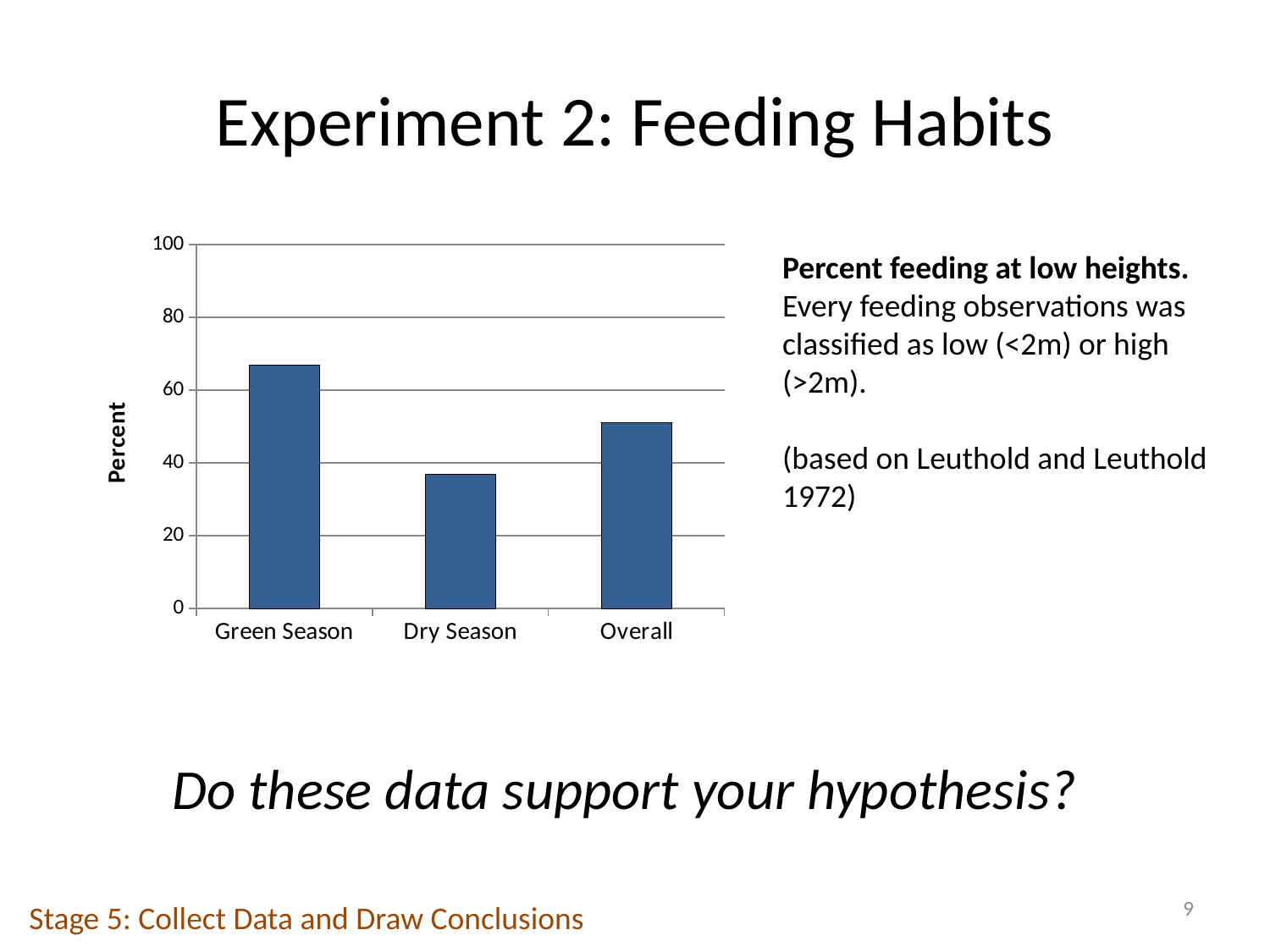
Which category has the highest bar in the chart? Green Season Is the value for Overall greater or less than 60? less What kind of chart is shown on the slide? bar chart What is the label on the y axis of the chart? Percent What is the maximum value shown on the y axis of the chart? 100 Is the value for Overall greater or less than 40? greater Which category has the lowest bar in the chart? Dry Season How many categories are shown on the x axis of the chart? 3 Is the value for Dry Season greater or less than 40? less Which is larger, the value for Dry Season or the value for Overall? Overall